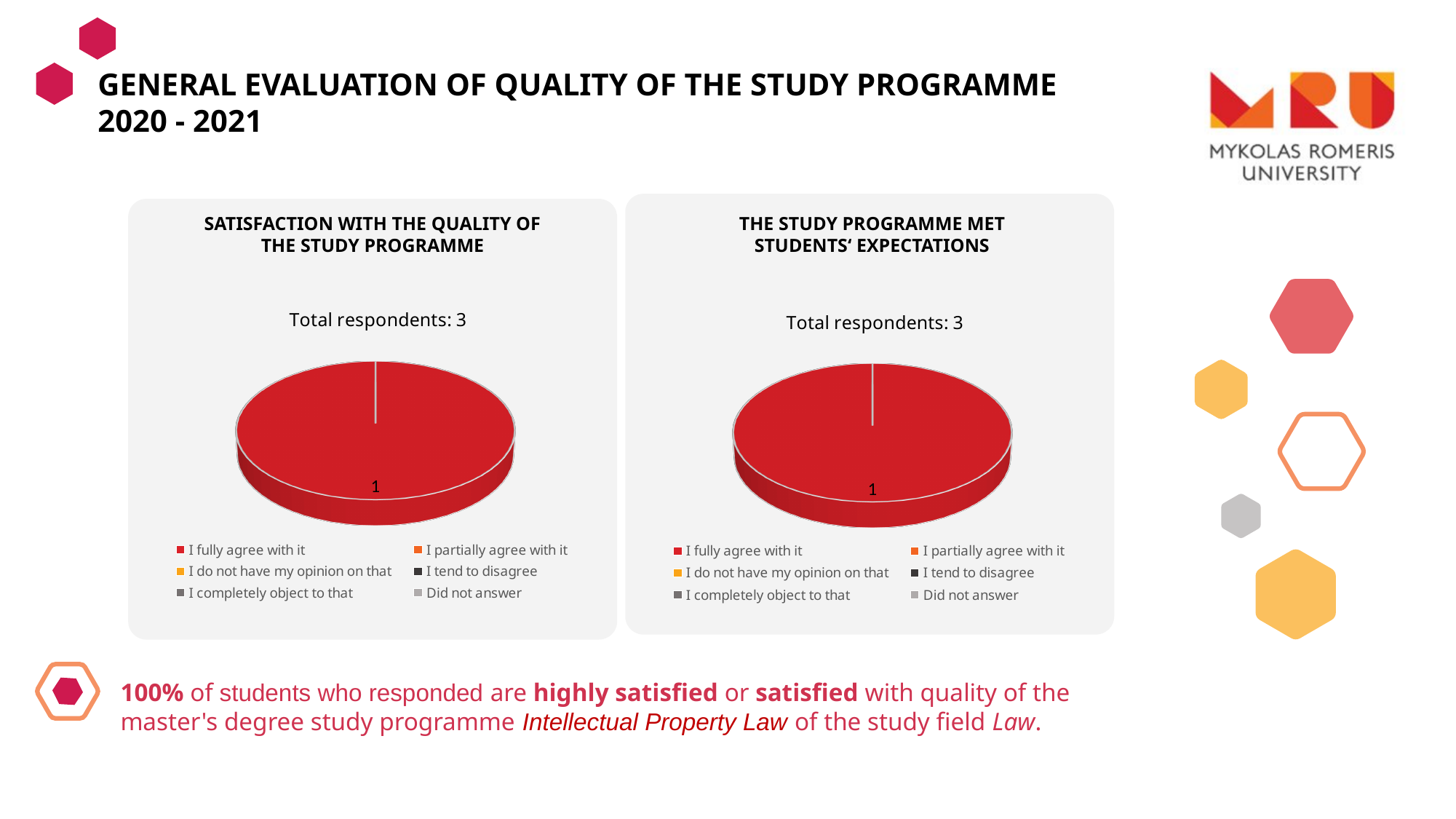
In the 'The study programme met students' expectations' chart, which legend category makes up the entire pie? I fully agree with it In the 'Satisfaction with the quality of the study programme' chart, what data label is printed on the pie? 1 What colour is the slice for 'I fully agree with it' in the 'Satisfaction with the quality of the study programme' chart? red In the 'Satisfaction with the quality of the study programme' chart, which legend category makes up the entire pie? I fully agree with it How many total respondents are reported for the 'The study programme met students' expectations' chart? 3 How many entries does the legend of the 'Satisfaction with the quality of the study programme' chart list? 6 What kind of chart is used in the 'The study programme met students' expectations' panel? pie chart In the 'The study programme met students' expectations' chart, what data label is printed on the pie? 1 How many entries does the legend of the 'The study programme met students' expectations' chart list? 6 What kind of chart is used in the 'Satisfaction with the quality of the study programme' panel? pie chart How many visible slices does the pie in the 'Satisfaction with the quality of the study programme' chart have? 1